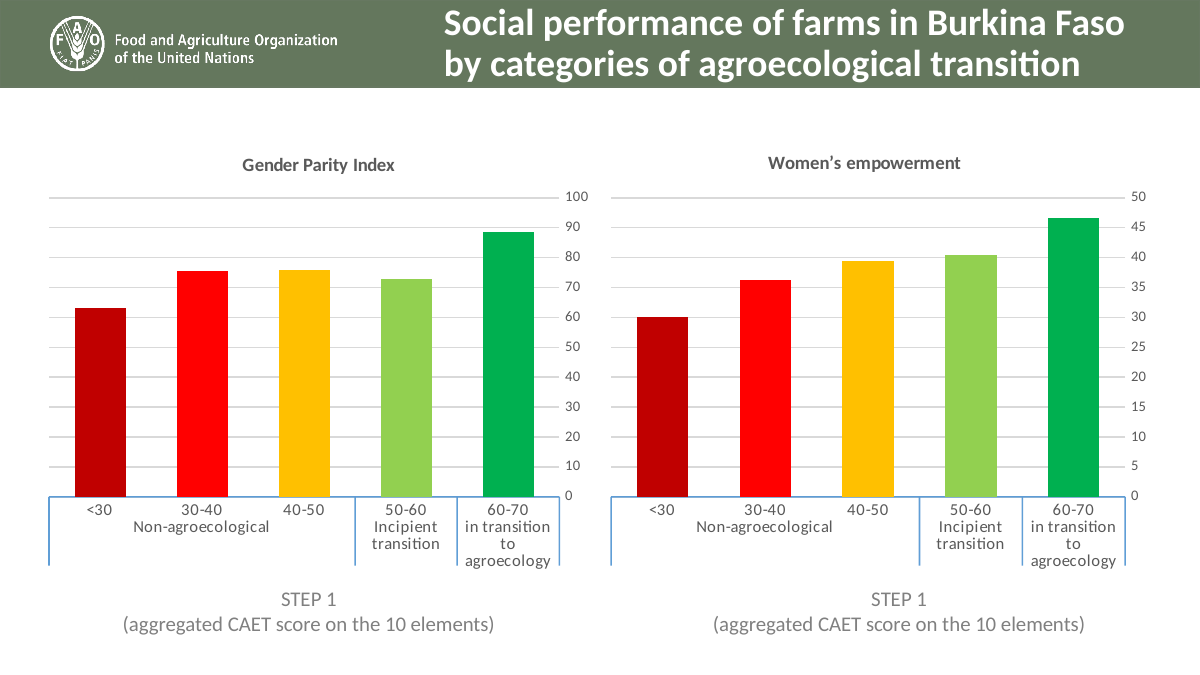
On the Women's empowerment chart, is the value for <30 greater or less than 35? less On the Women's empowerment chart, which category has the highest value? 60-70 On the Women's empowerment chart, is the value for 60-70 greater or less than 45? greater On the Women's empowerment chart, which is larger, the value for 30-40 or the value for 60-70? 60-70 On the Gender Parity Index chart, is the value for <30 greater or less than 70? less On the Women's empowerment chart, do the values generally rise or fall from <30 to 60-70? rise On the Women's empowerment chart, which category has the lowest value? <30 What kind of chart is the Gender Parity Index chart? bar chart On the Gender Parity Index chart, which category has the lowest value? <30 How many categories are shown on the Gender Parity Index chart? 5 On the Gender Parity Index chart, which category has the highest value? 60-70